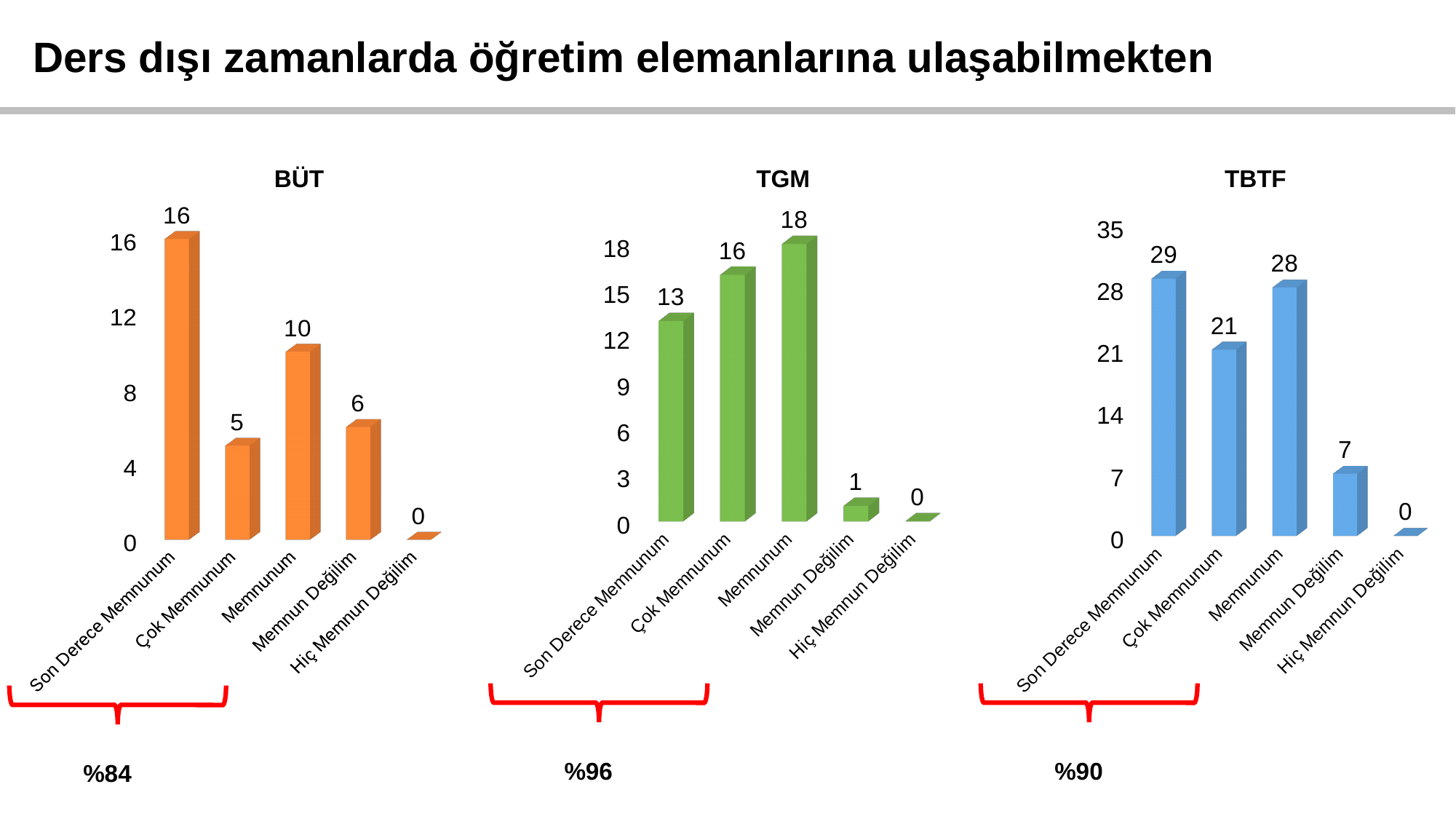
In the TBTF chart, which category has the highest value? Son Derece Memnunum In the TGM chart, what is the value for Memnun Değilim? 1 In the BÜT chart, what is the value for Son Derece Memnunum? 16 In the TGM chart, which category has the highest value? Memnunum In the TBTF chart, what is the difference between Memnunum and Memnun Değilim? 21 How many categories does the TBTF chart show? 5 What percentage is shown below the bracket under the TGM chart? %96 What kind of chart is the TGM chart? bar chart In the TBTF chart, what is the value for Çok Memnunum? 21 In the BÜT chart, what is the difference between Son Derece Memnunum and Memnunum? 6 In the BÜT chart, which category has the lowest value? Hiç Memnun Değilim In the TGM chart, which is larger, Çok Memnunum or Son Derece Memnunum? Çok Memnunum